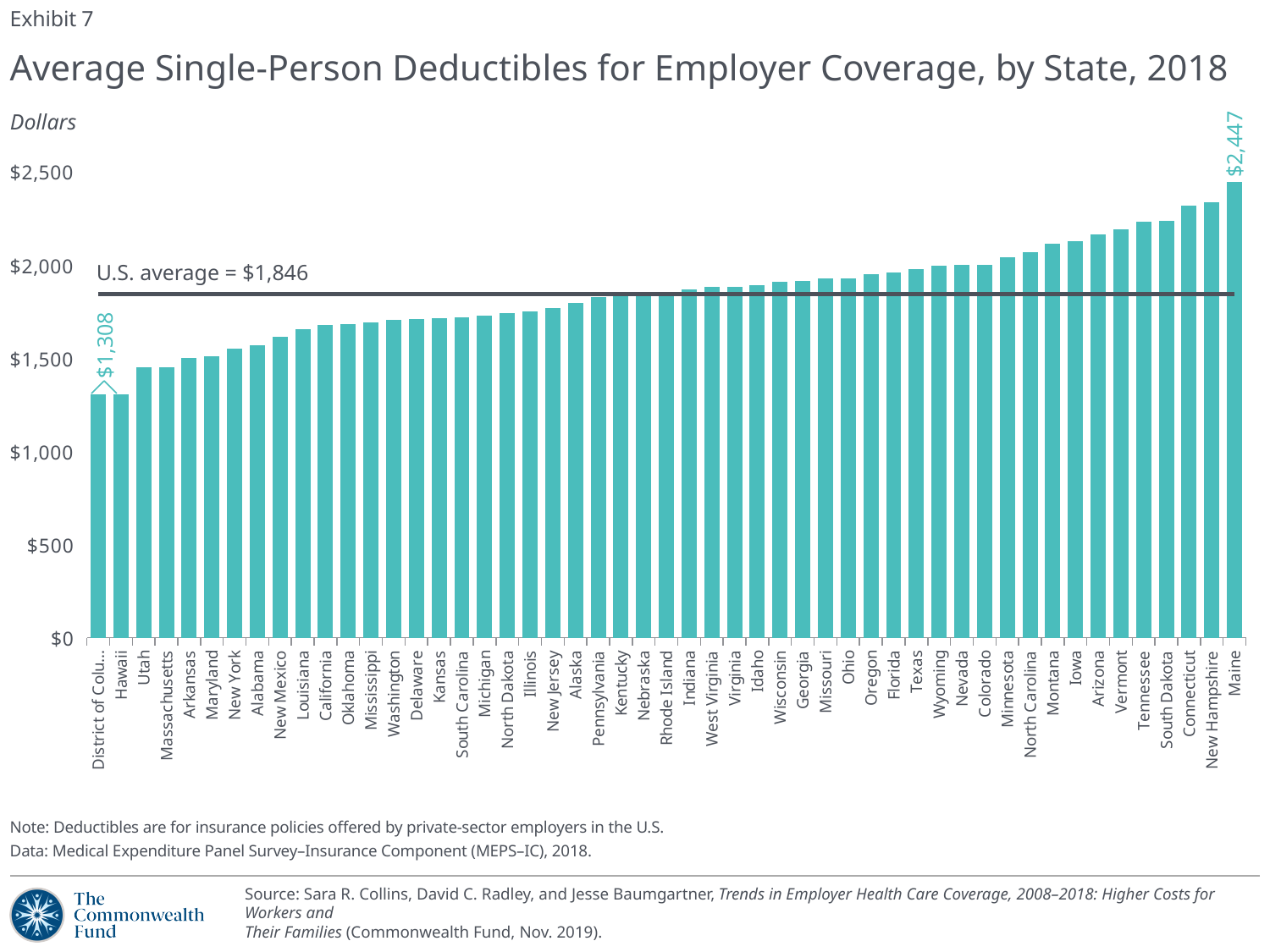
How many bars (states plus the District of Columbia) are plotted on the chart? 51 What value is labeled for the District of Columbia bar? $1,308 Is the value for Utah greater or less than $1,500? less What is the average single-person deductible shown for Maine? $2,447 Is the value for Alabama greater or less than $1,500? greater Which has a higher average deductible, Vermont or Utah? Vermont Is the value for Connecticut greater or less than $2,000? greater What is the U.S. average deductible shown on the chart? $1,846 What is the difference between the deductible for Maine and the deductible for the District of Columbia? $1,139 Do the bar values rise or fall moving from left to right along the x axis? Rise Which state has the highest average single-person deductible? Maine What kind of chart is shown on the slide? Bar chart